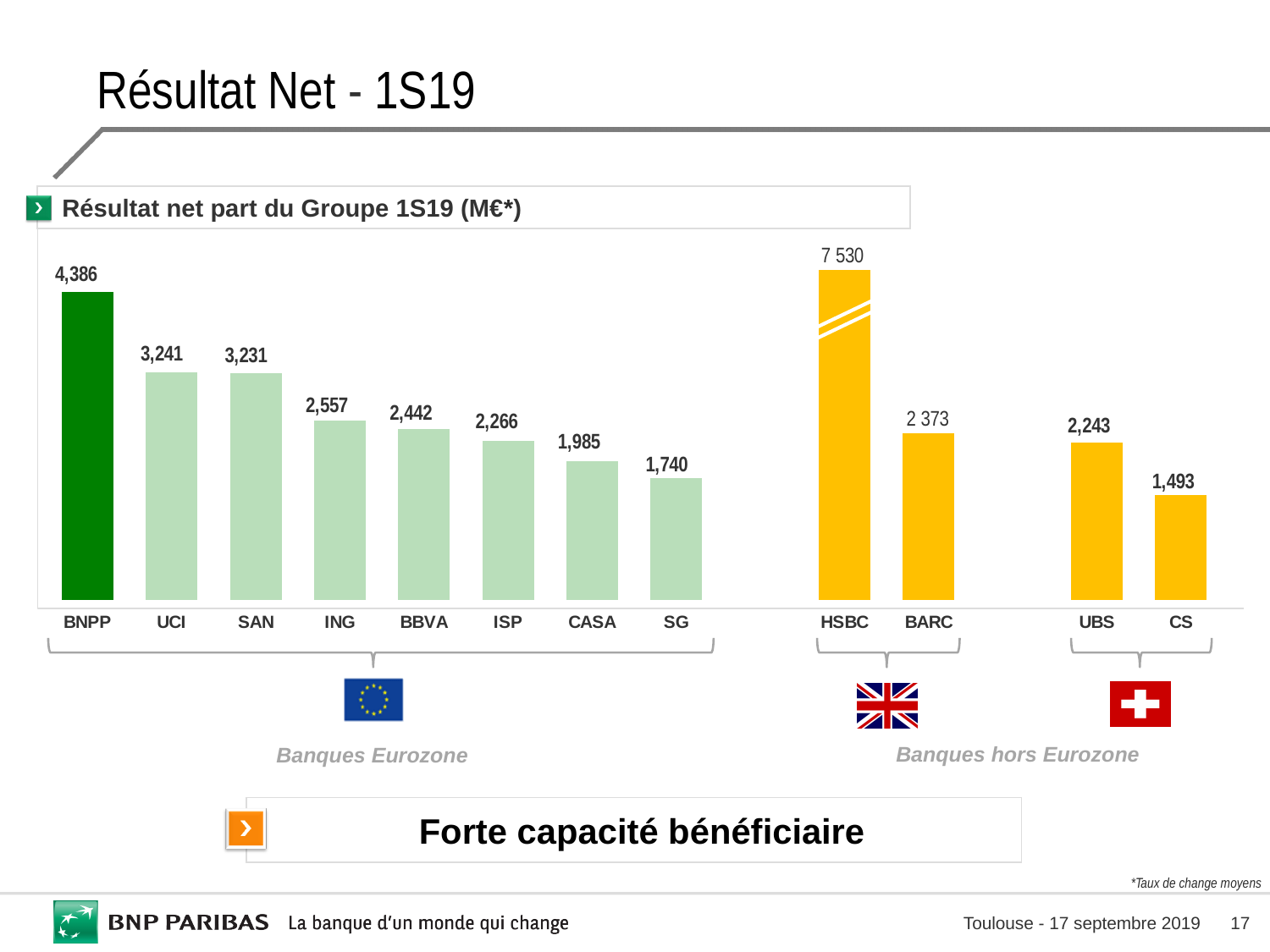
Which bank has the highest value on the chart? HSBC What kind of chart is shown on the slide? Bar chart Which bank has the lowest value on the chart? CS What is the difference between the values for UBS and CS? 750 What value is shown for SG? 1,740 What value is shown for HSBC? 7 530 What is the title of the chart? Résultat net part du Groupe 1S19 (M€*) What is the net income value shown for BNPP? 4,386 Which is larger, the value for ING or the value for SG? ING What value is shown for BARC? 2 373 What is the difference between the values for BNPP and UCI? 1,145 How many banks are shown on the chart? 12